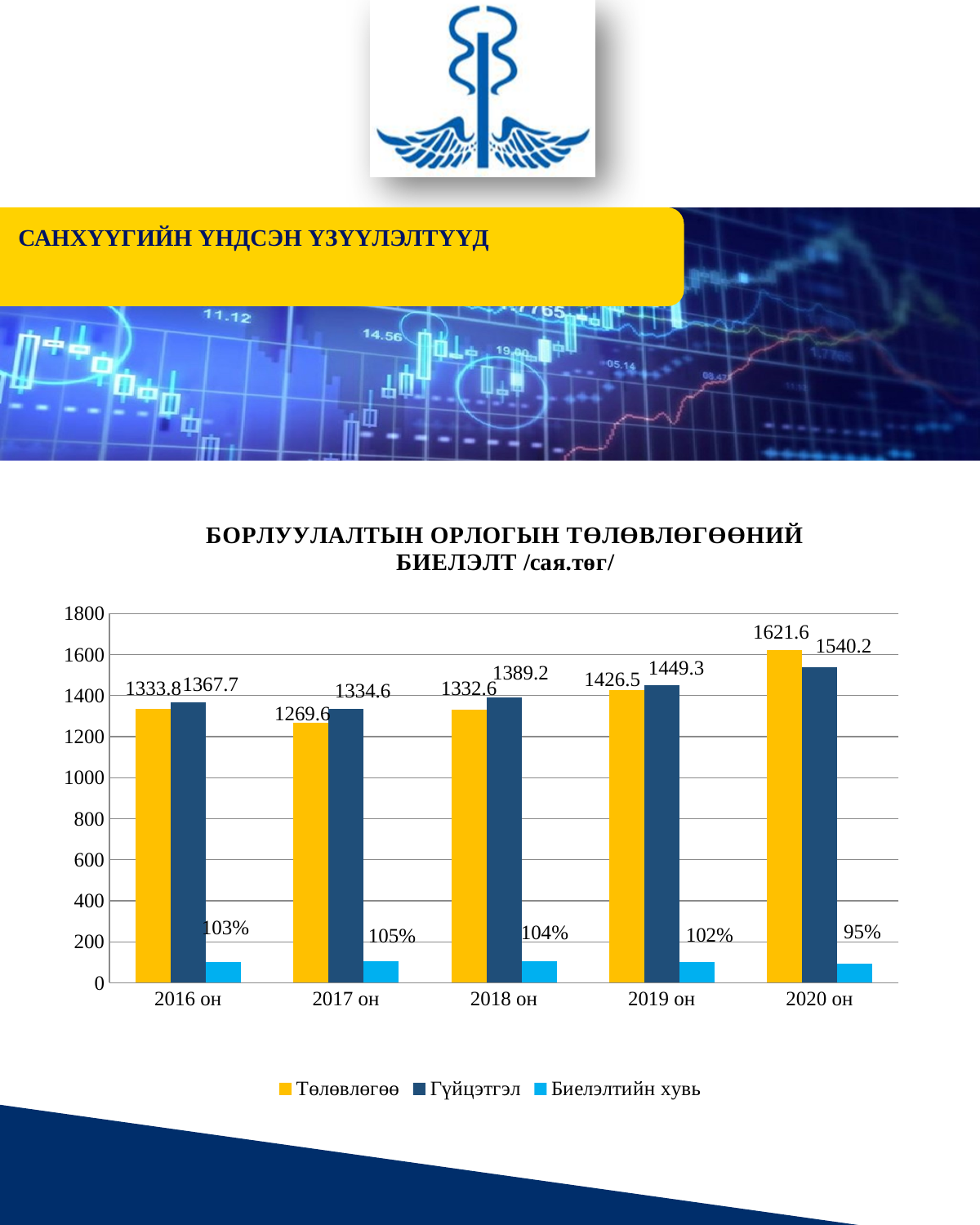
Which year has the highest Гүйцэтгэл value? 2020 он How many series does the legend list? 3 Which series is shown in yellow in the legend? Төлөвлөгөө How many years are shown on the x axis? 5 Is the Төлөвлөгөө value for 2016 он greater or less than 1400? less What is the Төлөвлөгөө value for 2020 он? 1621.6 What is the difference between the Гүйцэтгэл and Төлөвлөгөө values for 2019 он? 22.8 What is the Гүйцэтгэл value for 2018 он? 1389.2 Which is larger for 2020 он, Төлөвлөгөө or Гүйцэтгэл? Төлөвлөгөө What is the Биелэлтийн хувь value for 2017 он? 105% Which year has the lowest Төлөвлөгөө value? 2017 он What kind of chart is shown on the slide? bar chart